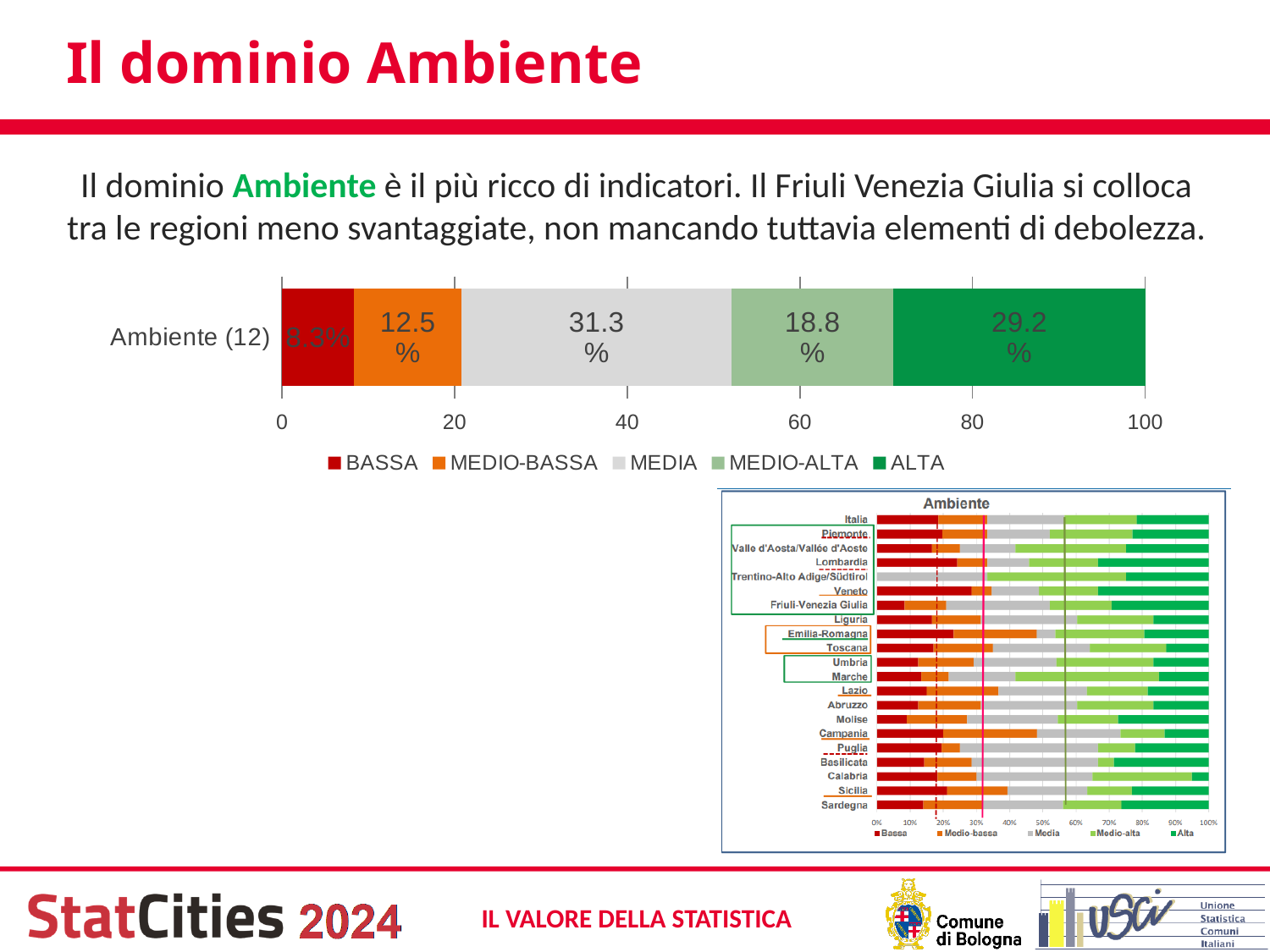
In the stacked bar chart for Ambiente (12), which series has the largest segment? MEDIA In the stacked bar chart for Ambiente (12), what is the value of the BASSA segment? 8.3% In the stacked bar chart for Ambiente (12), which series has the smallest segment? BASSA In the stacked bar chart for Ambiente (12), what is the value of the MEDIO-BASSA segment? 12.5% In the stacked bar chart for Ambiente (12), which is larger, the MEDIO-ALTA segment or the MEDIO-BASSA segment? MEDIO-ALTA In the stacked bar chart for Ambiente (12), what is the value of the MEDIA segment? 31.3% How many categories are plotted in the Ambiente (12) stacked bar chart? 1 What kind of chart is the Ambiente (12) chart at the top of the slide? Stacked bar chart In the stacked bar chart for Ambiente (12), what is the value of the ALTA segment? 29.2% How many series does the legend of the Ambiente (12) stacked bar chart list? 5 In the stacked bar chart for Ambiente (12), what is the difference between the ALTA and MEDIO-ALTA values? 10.4% In the Ambiente (12) stacked bar chart, what colour is the ALTA segment? Dark green